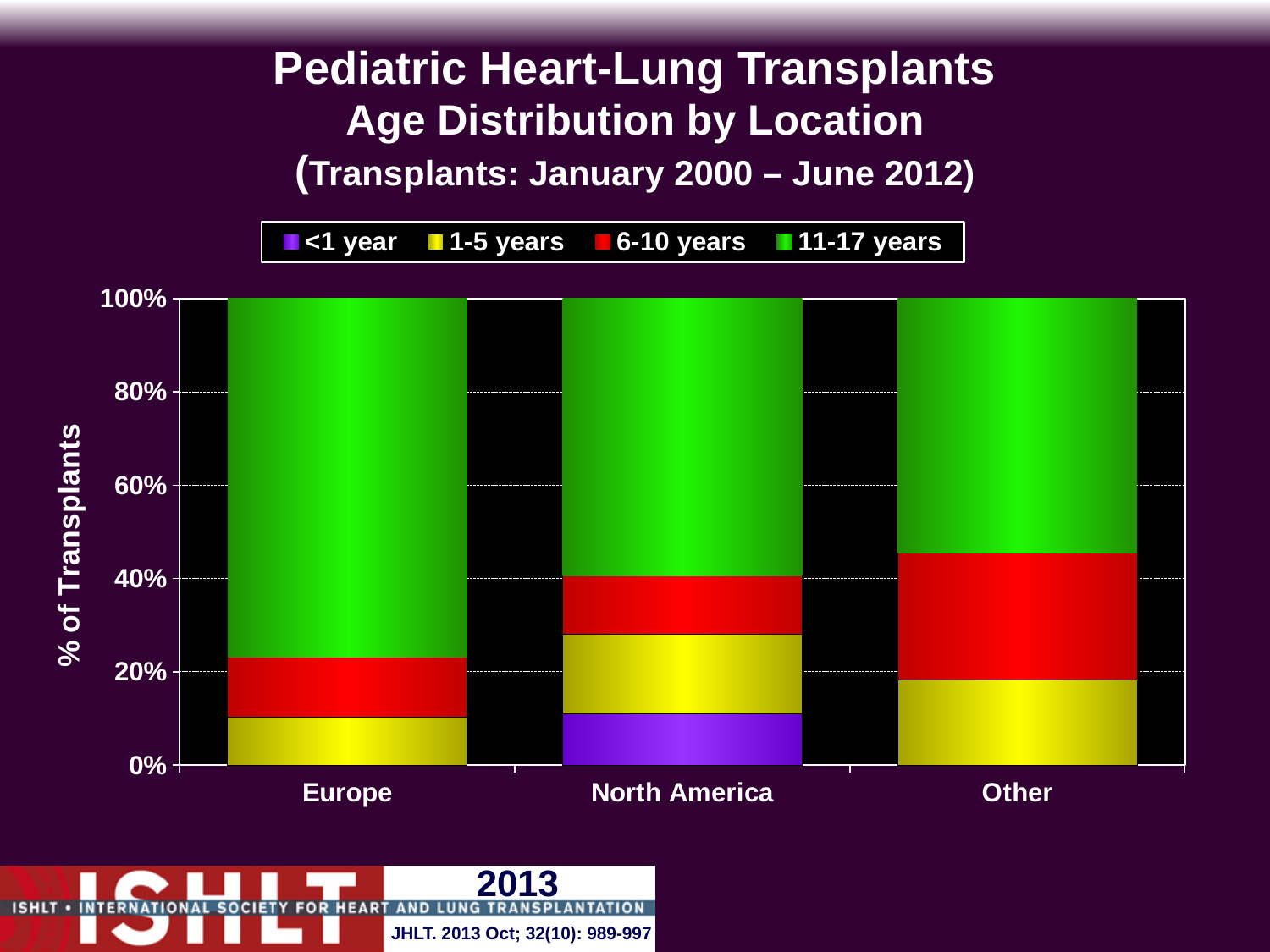
Is the 6-10 years share larger for Other or for Europe? Other Which location is the only one with a visible <1 year segment? North America What is the label on the y axis? % of Transplants How many locations are shown on the x axis? 3 What kind of chart is shown on the slide? Stacked bar chart Is the 1-5 years share larger for Other or for Europe? Other Is the share of 11-17 years transplants for Europe greater or less than 60%? greater Is the share of 11-17 years transplants for Other greater or less than 80%? less Which location has the smallest share of transplants in the 11-17 years age group? Other Which location has the largest share of transplants in the 11-17 years age group? Europe How many age groups does the legend list? 4 What does each stacked bar total? 100%